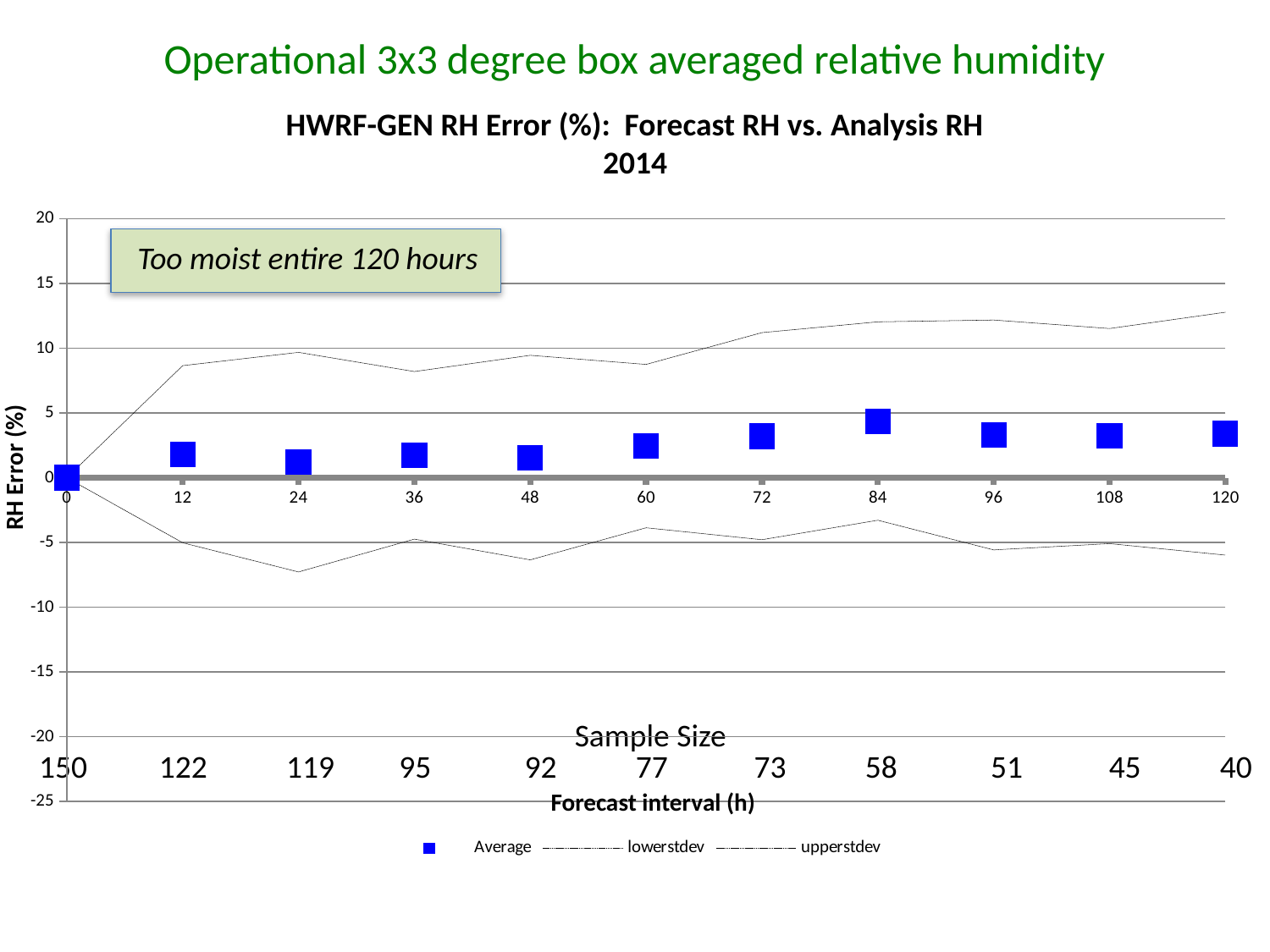
Is the upperstdev value at forecast interval 120 greater or less than 10? greater Which is larger, the Average RH error at forecast interval 84 or at forecast interval 24? 84 What is the Average RH error at forecast interval 0? 0 What sample size is shown for forecast interval 84? 58 How many forecast interval points are plotted for the Average series? 11 At which forecast interval is the Average RH error highest? 84 How many series does the chart legend list? 3 What is the label of the y axis? RH Error (%) Is the lowerstdev value at forecast interval 24 greater or less than -5? less What is the title of the chart? HWRF-GEN RH Error (%): Forecast RH vs. Analysis RH 2014 Does the Average RH error generally rise or fall from forecast interval 0 to 120? rise At which forecast interval is the Average RH error lowest? 0